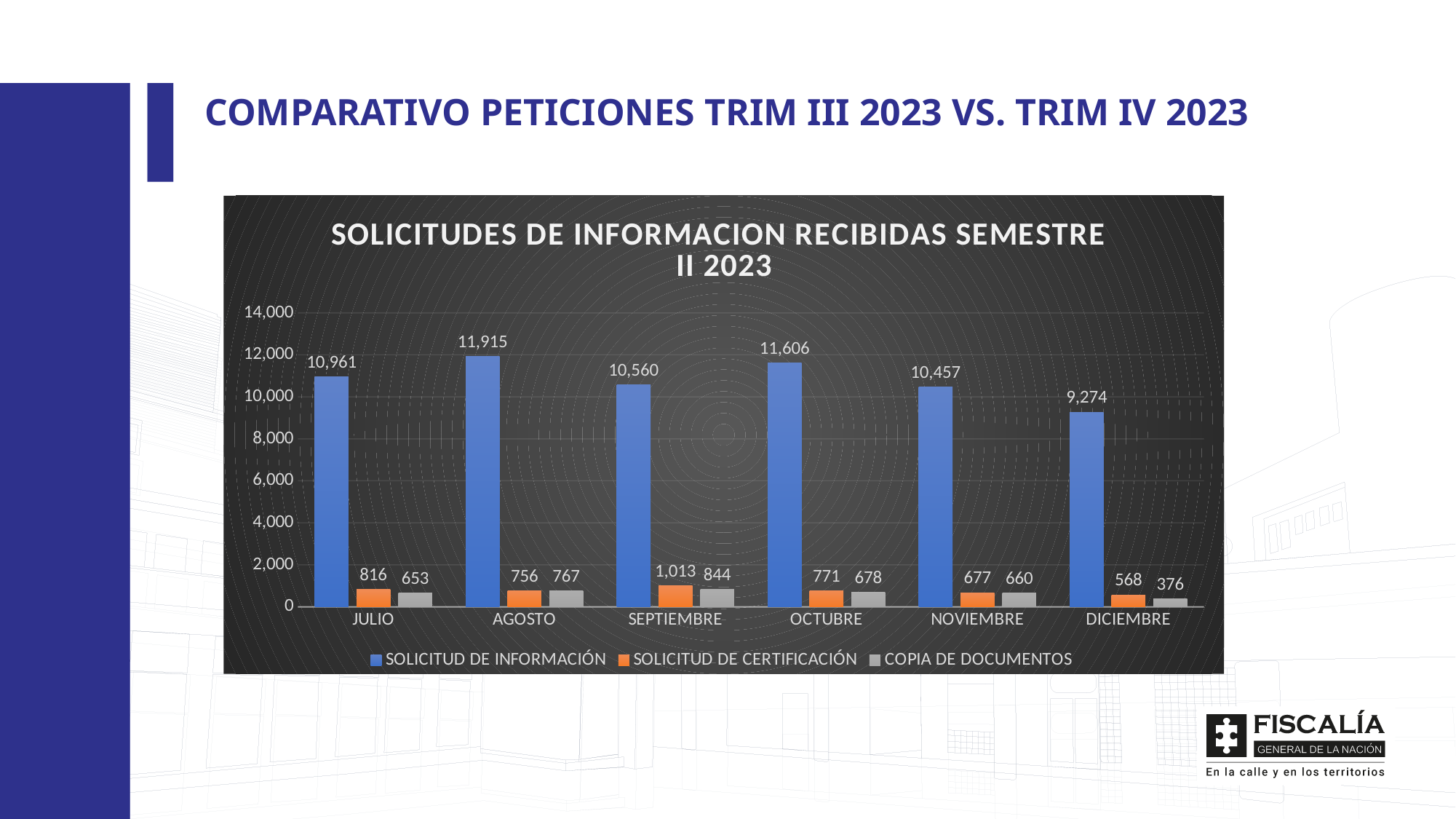
What kind of chart is shown? bar chart Which month has the lowest value for COPIA DE DOCUMENTOS? DICIEMBRE How many months are shown on the x axis? 6 What is the value of COPIA DE DOCUMENTOS for DICIEMBRE? 376 What is the value of SOLICITUD DE INFORMACIÓN for AGOSTO? 11,915 What is the difference between the SOLICITUD DE INFORMACIÓN values for AGOSTO and DICIEMBRE? 2,641 What is the title of the chart? SOLICITUDES DE INFORMACION RECIBIDAS SEMESTRE II 2023 Is the value of SOLICITUD DE INFORMACIÓN for DICIEMBRE greater or less than 10,000? less How many series does the legend list? 3 What is the value of SOLICITUD DE CERTIFICACIÓN for SEPTIEMBRE? 1,013 Which month has the highest value for SOLICITUD DE INFORMACIÓN? AGOSTO Which is larger, SOLICITUD DE CERTIFICACIÓN for JULIO or for NOVIEMBRE? JULIO